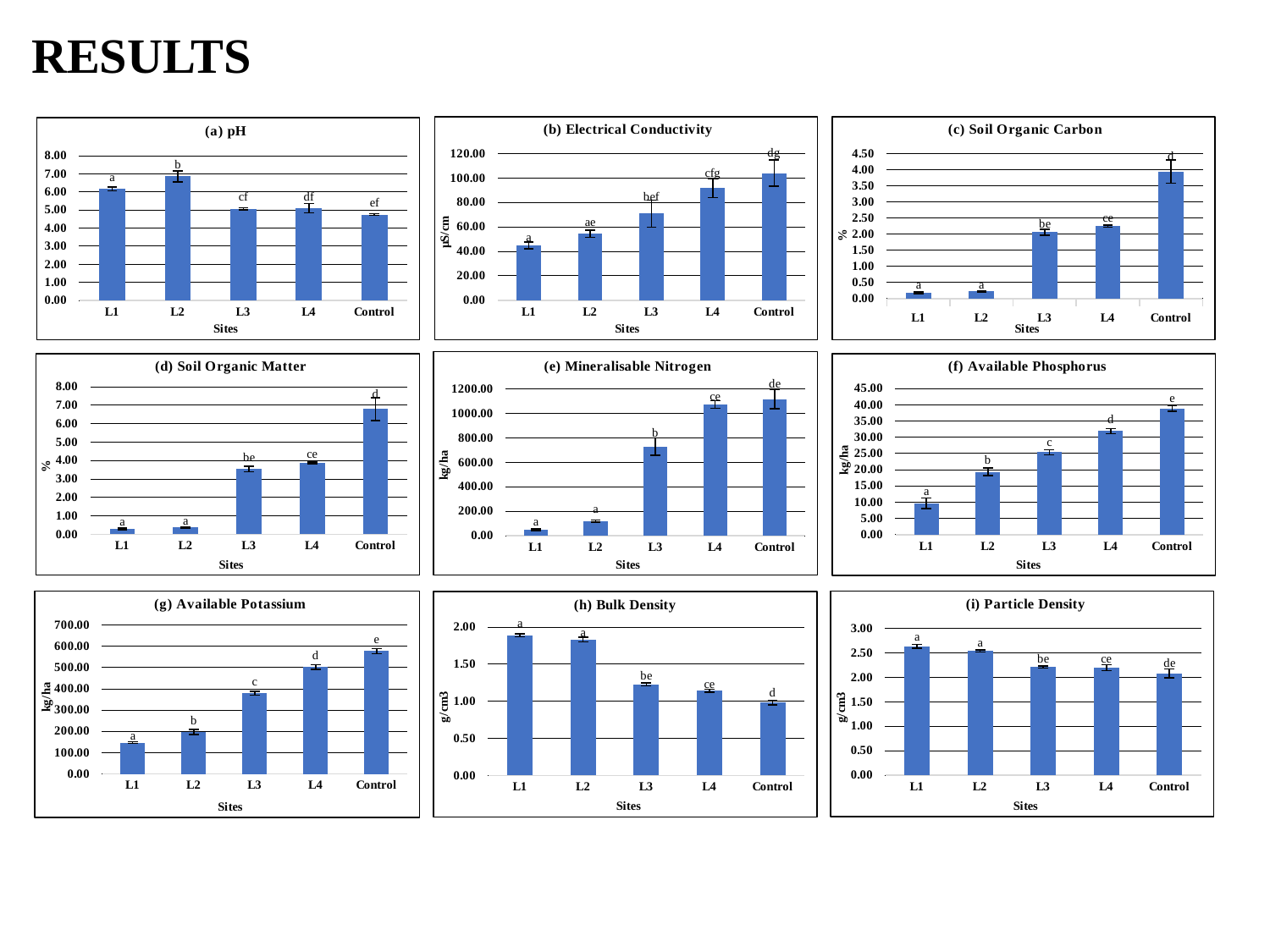
In the chart titled "(h) Bulk Density", which site has the lowest value? Control In the chart titled "(a) pH", which site has the highest bar? L2 In the chart titled "(i) Particle Density", do the values rise or fall from L1 to Control along the x axis? fall In the chart titled "(g) Available Potassium", is the value for L3 greater or less than 300.00? greater In the chart titled "(d) Soil Organic Matter", which site has the highest value? Control In the chart titled "(b) Electrical Conductivity", do the values rise or fall from L1 to Control along the x axis? rise In the chart titled "(f) Available Phosphorus", which is larger, the value for L2 or the value for L4? L4 In the chart titled "(e) Mineralisable Nitrogen", is the value for L3 greater or less than 600.00? greater What unit is shown on the y axis of the chart titled "(b) Electrical Conductivity"? µS/cm How many sites are shown on the x axis of the chart titled "(g) Available Potassium"? 5 In the chart titled "(c) Soil Organic Carbon", is the value for Control greater or less than 3.50? greater In the chart titled "(b) Electrical Conductivity", which site has the lowest value? L1